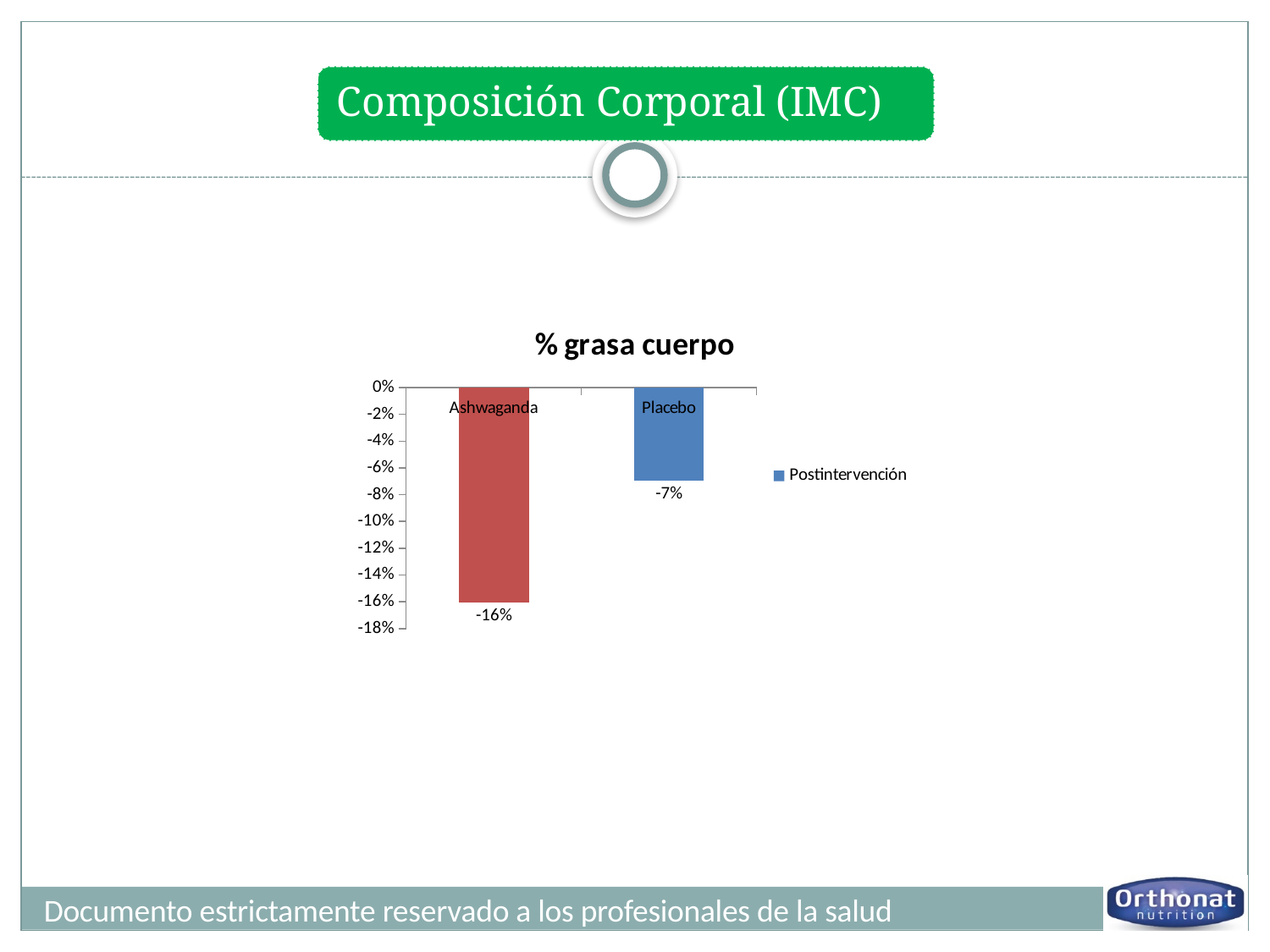
What is the difference between the Ashwaganda and Placebo values? 9 percentage points What is the name of the series listed in the legend? Postintervención How many series does the legend list? 1 Which category shows the largest reduction in body fat percentage? Ashwaganda What is the value for Placebo in the '% grasa cuerpo' chart? -7% What is the value for Ashwaganda in the '% grasa cuerpo' chart? -16% What kind of chart is shown on the slide? Bar chart Which bar is longer, Ashwaganda or Placebo? Ashwaganda Which category shows the smallest reduction in body fat percentage? Placebo How many categories are shown in the chart? 2 What is the title of the chart? % grasa cuerpo Is the value for Ashwaganda less than -10%? Yes